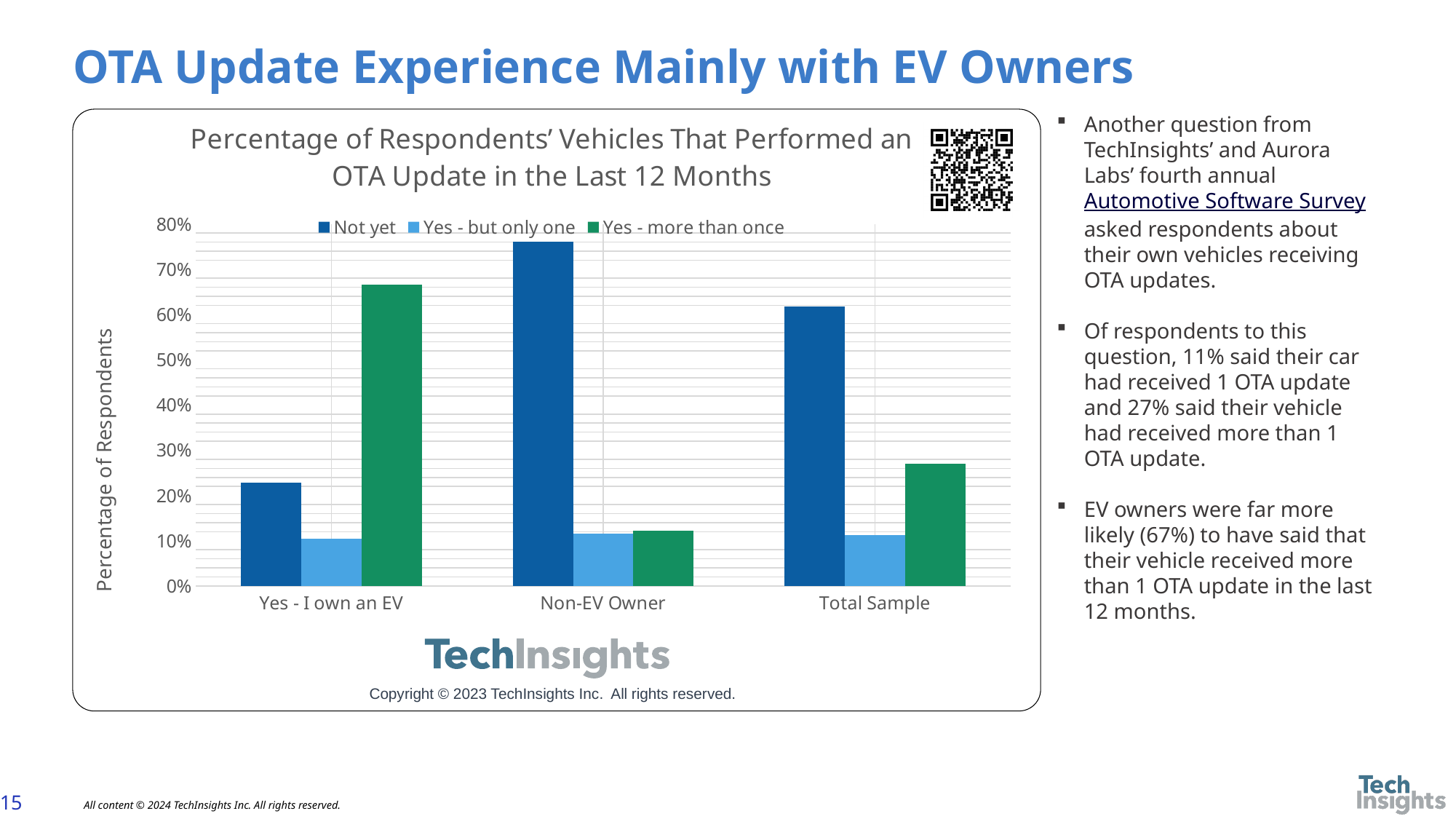
Is the 'Yes - more than once' value for Total Sample greater or less than 20%? greater Which is larger: the 'Not yet' value for Non-EV Owner or the 'Not yet' value for Total Sample? Non-EV Owner For 'Total Sample', which series has the lowest value? Yes - but only one Is the 'Not yet' value for 'Yes - I own an EV' greater or less than 30%? less What kind of chart is shown on the slide? bar chart How many series does the legend list? 3 How many categories are shown on the x axis? 3 Is the 'Yes - more than once' value for 'Yes - I own an EV' greater or less than 60%? greater Which category has the highest 'Not yet' value? Non-EV Owner For 'Yes - I own an EV', which series has the highest value? Yes - more than once What is the label on the y axis of the chart? Percentage of Respondents